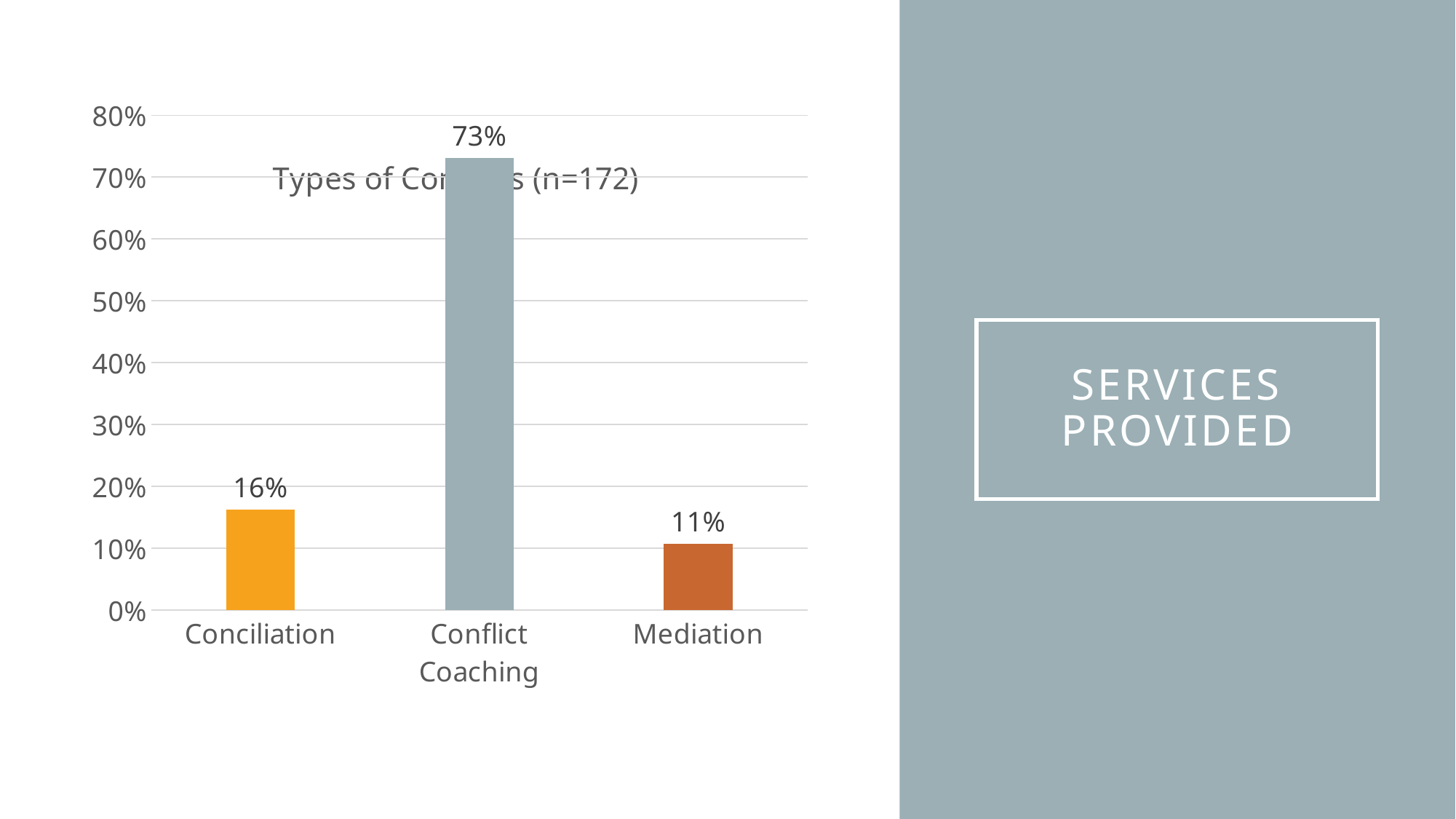
Which category has the highest value? Conflict Coaching What sample size (n) is given in the chart title? 172 What is the value for Conflict Coaching? 73% What kind of chart is shown on the slide? bar chart Which is larger, the value for Conciliation or the value for Mediation? Conciliation What is the value for Mediation? 11% What is the difference between the values for Conciliation and Mediation? 5% What is the difference between the values for Conflict Coaching and Conciliation? 57% Is the value for Conflict Coaching greater or less than 70%? greater Which category has the lowest value? Mediation How many categories are shown on the x axis? 3 What is the value for Conciliation? 16%